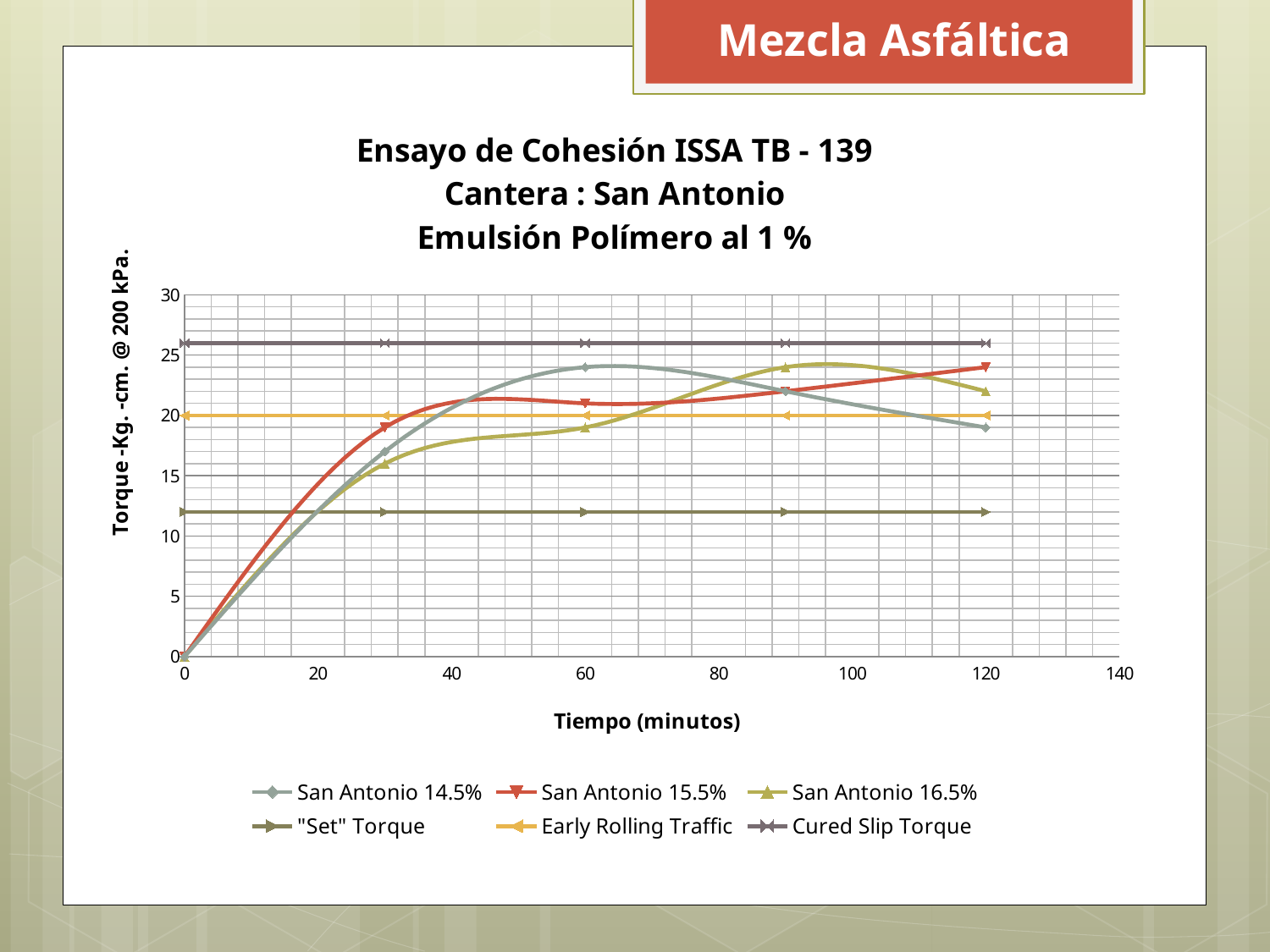
How many series does the legend list? 6 At 60 minutes, which is higher: San Antonio 14.5% or San Antonio 16.5%? San Antonio 14.5% What kind of chart is shown on the slide? line chart Is the value for San Antonio 14.5% at 60 minutes greater or less than 20? greater Is the value of the "Set" Torque line greater or less than 15? less How many data points are plotted for the San Antonio 14.5% series? 5 What torque value does the Early Rolling Traffic line sit at? 20 Is the value for San Antonio 16.5% at 30 minutes greater or less than 20? less Does the San Antonio 15.5% series rise or fall between 0 and 30 minutes? rises What is the title of the x axis? Tiempo (minutos) At 120 minutes, which is higher: San Antonio 15.5% or San Antonio 14.5%? San Antonio 15.5%